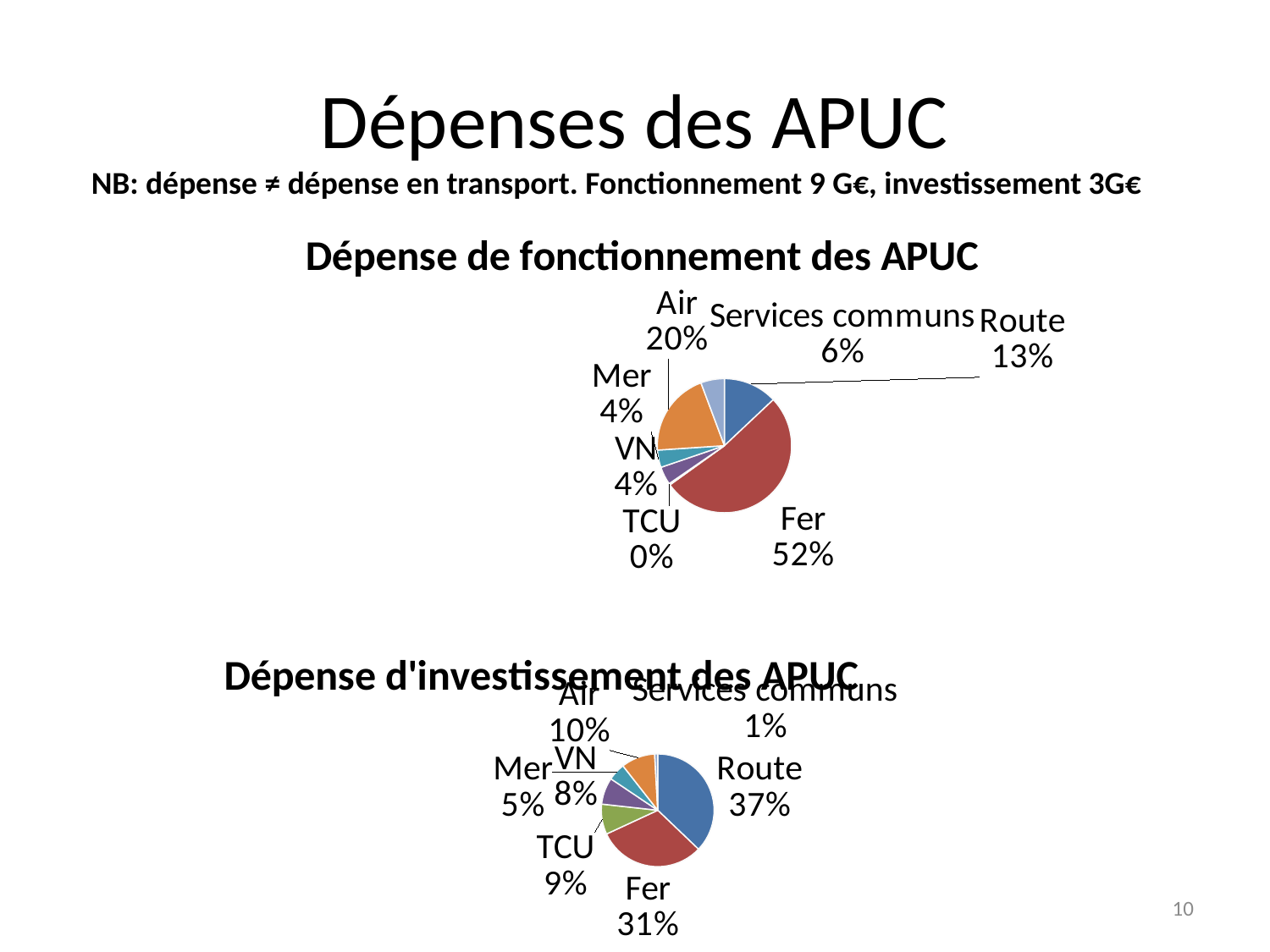
In the 'Dépense d'investissement des APUC' chart, which category has the largest share? Route In the 'Dépense d'investissement des APUC' chart, which is larger, the share of Air or the share of Mer? Air What type of chart is used for 'Dépense d'investissement des APUC'? Pie chart In the 'Dépense de fonctionnement des APUC' chart, which category has the largest share? Fer In the 'Dépense d'investissement des APUC' chart, which category has the smallest share? Services communs In the 'Dépense de fonctionnement des APUC' chart, what is the difference between the shares of Fer and Route? 39% In the 'Dépense de fonctionnement des APUC' chart, how many categories are shown? 7 In the 'Dépense d'investissement des APUC' chart, what share does TCU have? 9% In the 'Dépense d'investissement des APUC' chart, what share does Route have? 37% In the 'Dépense de fonctionnement des APUC' chart, what share does Fer have? 52% In the 'Dépense de fonctionnement des APUC' chart, which category has the smallest share? TCU